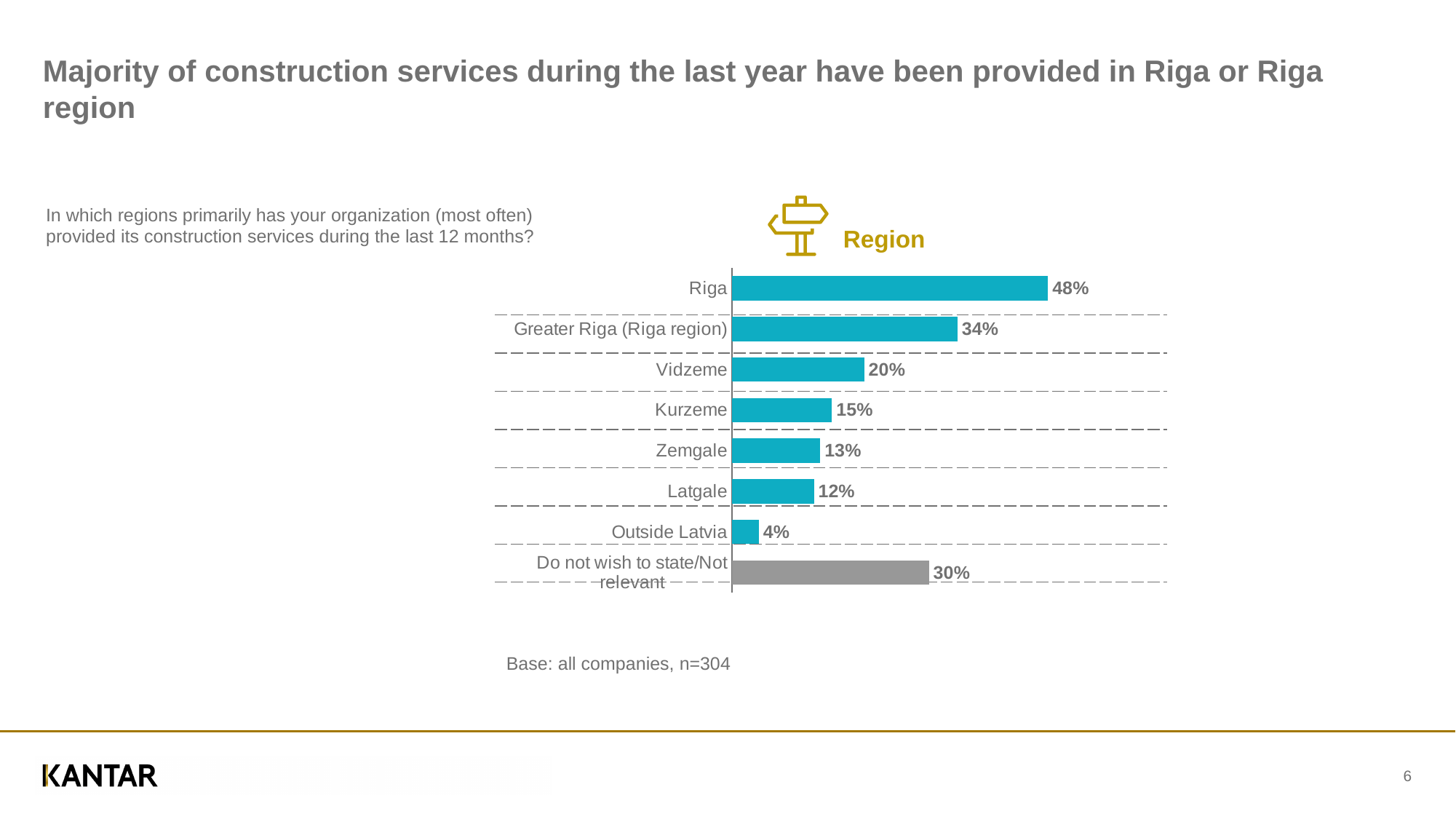
Which region has the highest value? Riga What is the value for Vidzeme? 20% What is the value for Greater Riga (Riga region)? 34% What is the value for Do not wish to state/Not relevant? 30% What is the value for Outside Latvia? 4% What is the title shown above the chart? Region What is the difference between the values for Riga and Greater Riga (Riga region)? 14% How many categories are shown in the chart? 8 Which is larger, the value for Kurzeme or the value for Zemgale? Kurzeme What type of chart is shown on the slide? Bar chart Which category has the lowest value? Outside Latvia What percentage of companies provided construction services in Riga? 48%